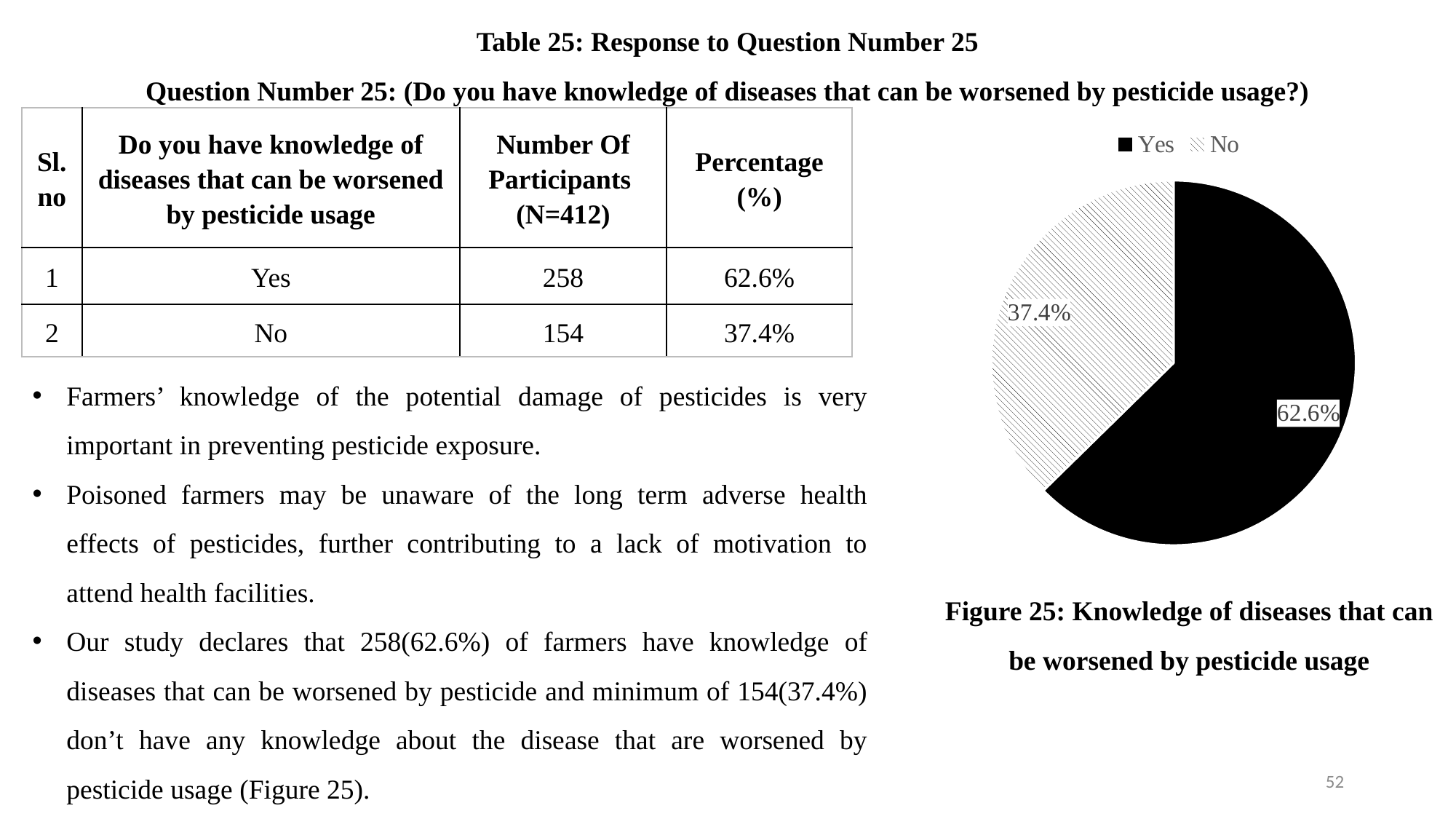
In the pie chart, which is larger, the Yes slice or the No slice? Yes What is the caption of the pie chart? Figure 25: Knowledge of diseases that can be worsened by pesticide usage In the pie chart, what percentage is shown for the Yes slice? 62.6% In the pie chart, what percentage is shown for the No slice? 37.4% What share of the pie does the No slice represent? 37.4% How many entries does the legend of the pie chart list? 2 How many slices does the pie chart have? 2 What is the difference in percentage points between the Yes and No slices in the pie chart? 25.2 What kind of chart is shown in Figure 25? pie chart Which slice of the pie chart is the largest? Yes Which legend entry in the pie chart is shown with a solid black fill? Yes Which slice of the pie chart is the smallest? No